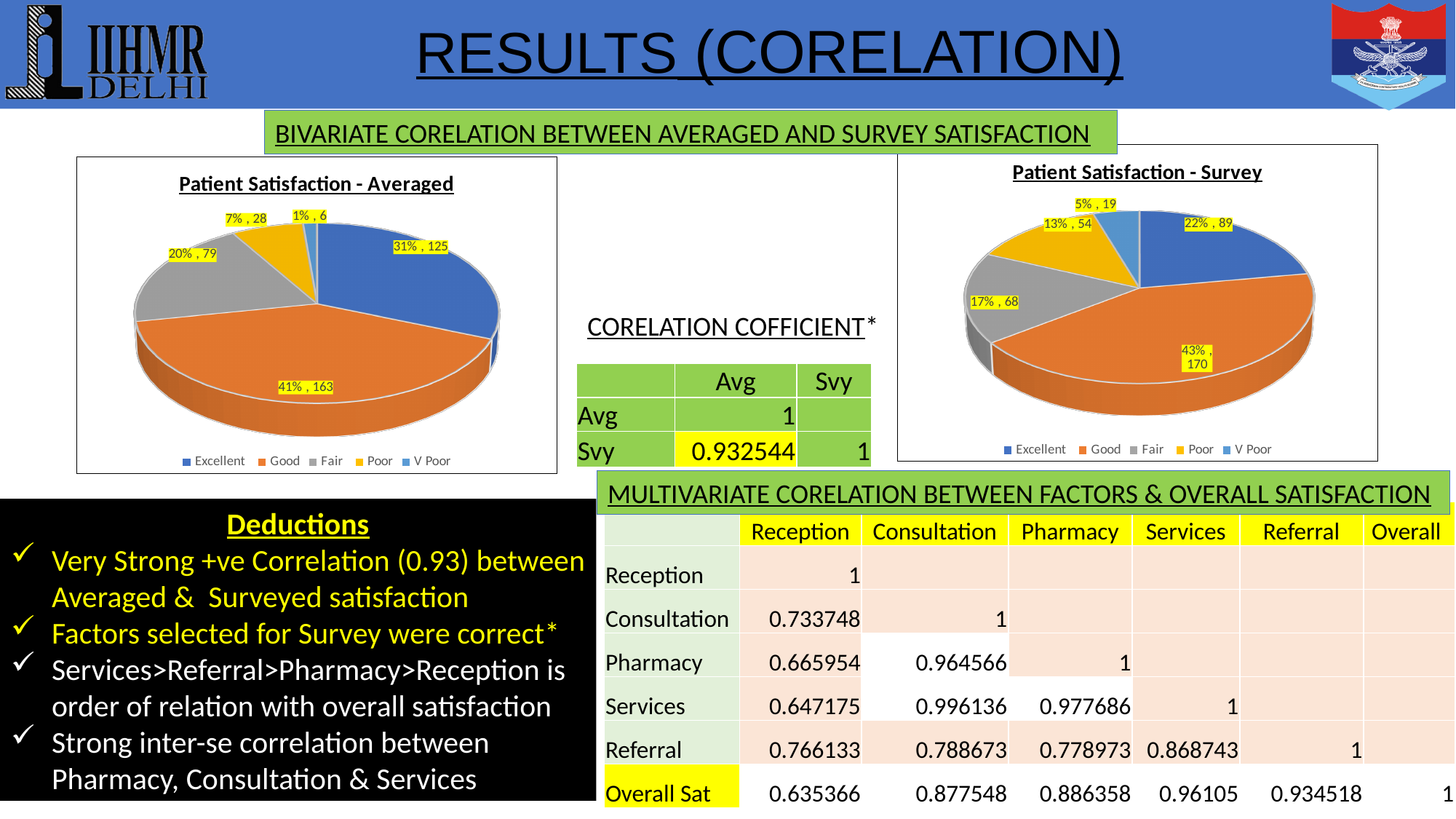
In the 'Patient Satisfaction - Survey' chart, which colour represents the Good category? Orange In the 'Patient Satisfaction - Averaged' chart, which category has the smallest slice? V Poor In the 'Patient Satisfaction - Survey' chart, what is the difference in count between the Excellent and Fair slices? 21 In the 'Patient Satisfaction - Survey' chart, what count is shown for the Good slice? 170 In the 'Patient Satisfaction - Survey' chart, which is larger, the Fair slice or the Poor slice? Fair How many categories does the legend of the 'Patient Satisfaction - Averaged' chart list? 5 In the 'Patient Satisfaction - Averaged' chart, which category has the largest slice? Good In the 'Patient Satisfaction - Survey' chart, what percentage share does the Poor slice have? 13% In the 'Patient Satisfaction - Averaged' chart, what percentage share does the Good slice have? 41% What kind of chart is 'Patient Satisfaction - Survey'? Pie chart In the 'Patient Satisfaction - Averaged' chart, what count is shown for the Excellent slice? 125 In the 'Patient Satisfaction - Averaged' chart, what is the difference in count between the Good and Excellent slices? 38